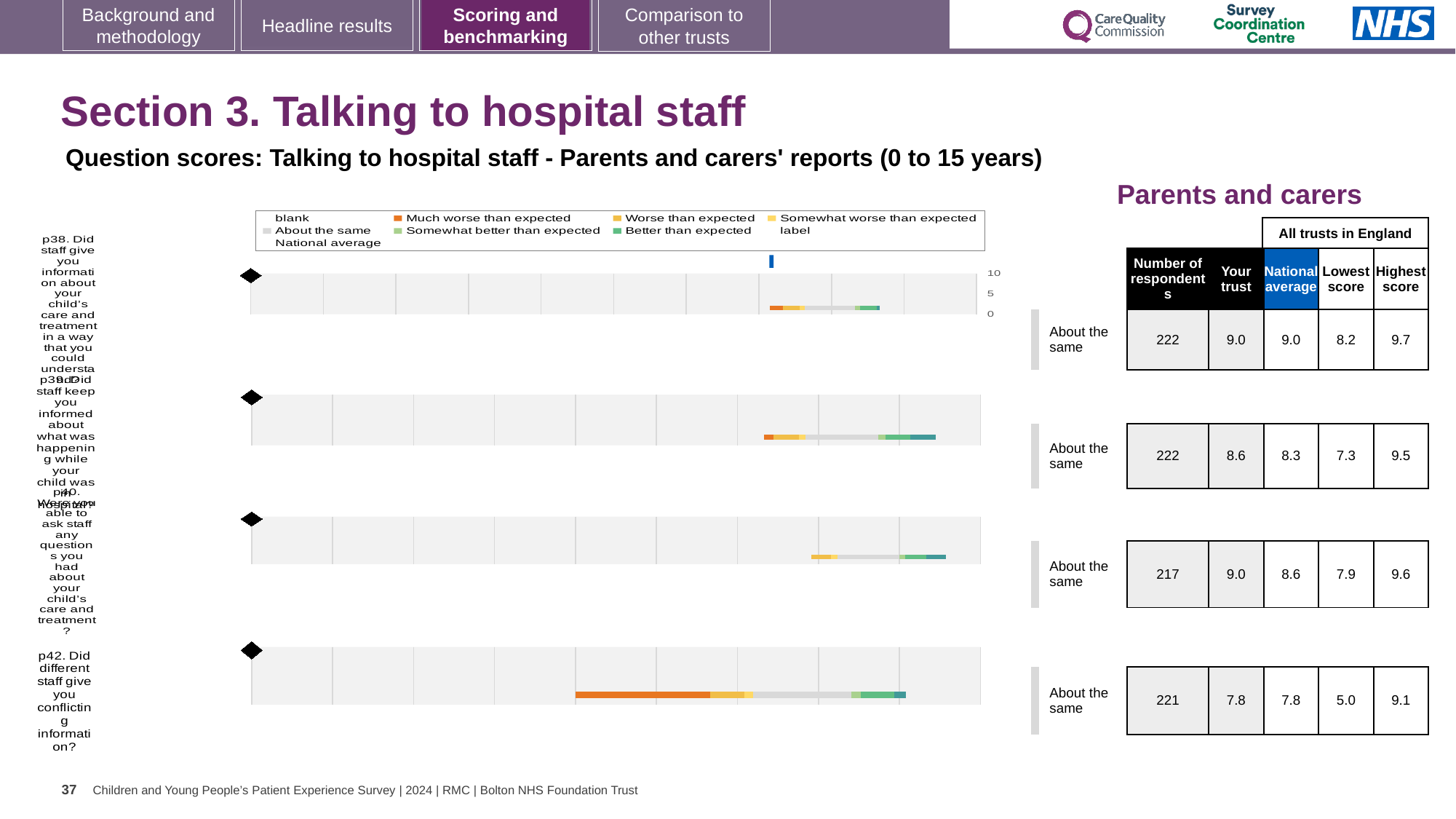
For the p38 chart (staff giving information about your child's care in a way you could understand), how many respondents are listed in the table? 222 For the p42 chart (different staff giving conflicting information), what is the 'Your trust' score? 7.8 What kind of chart is used to show the benchmarking results for each question on this slide? Bar chart What benchmark category is shown next to each of the four charts? About the same For the p39 chart (staff keeping you informed about what was happening), what is the difference between the 'Your trust' score and the national average? 0.3 How many question charts (p38, p39, p40, p42) are shown on the slide? 4 For the p40 chart (able to ask staff any questions), what is the national average score? 8.6 Which question has the highest 'Highest score' across all trusts in England? p38 (9.7) In the chart legend, what colour represents 'Much worse than expected'? Orange For the p39 chart, what is the lowest score among all trusts in England? 7.3 Which question has the lowest 'Lowest score' across all trusts in England? p42 (5.0) For the p40 chart, which is larger: the 'Your trust' score or the national average? Your trust (9.0)